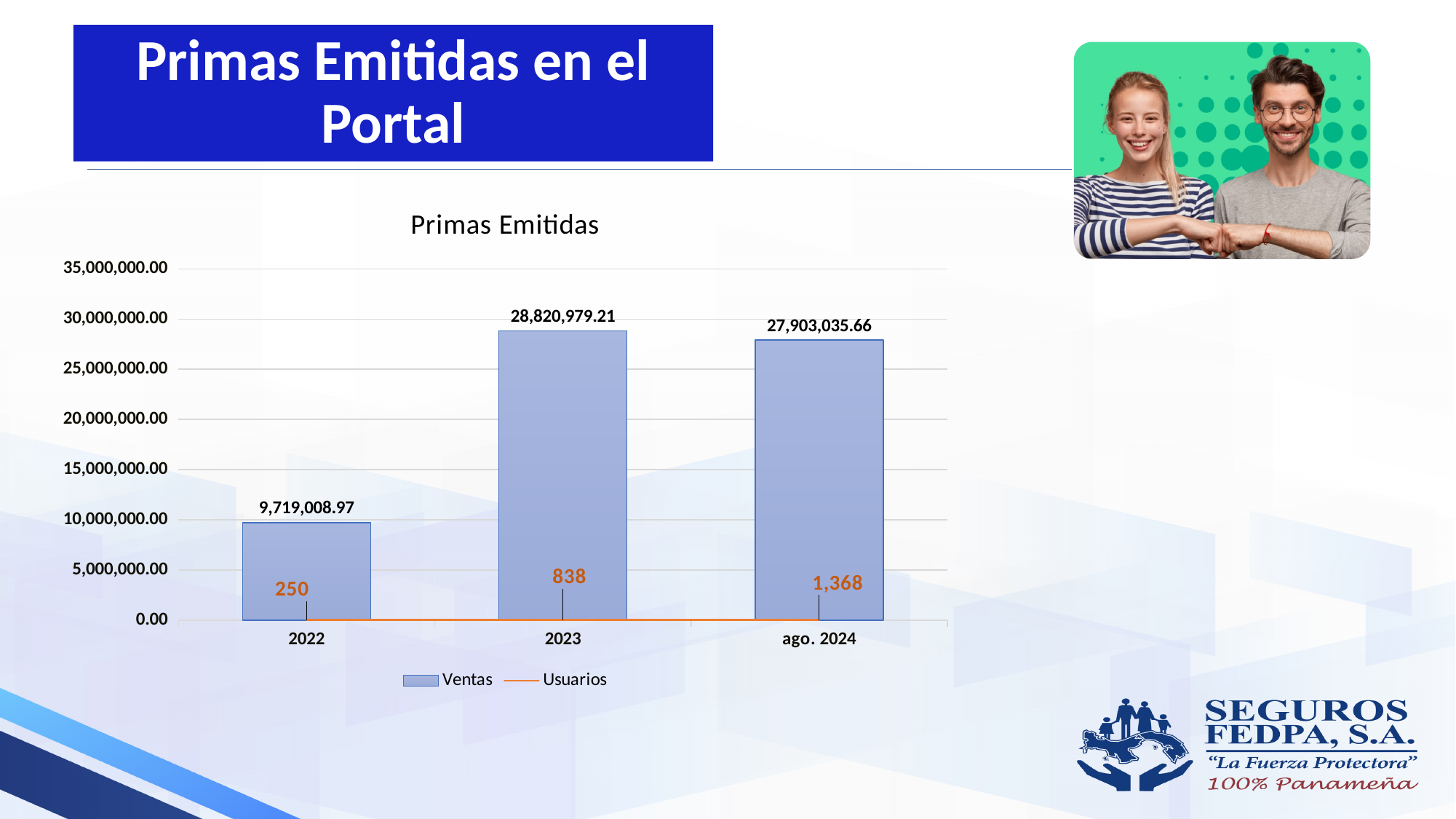
What is the difference between the Ventas values for 2023 and ago. 2024? 917,943.55 What is the Usuarios value for 2023? 838 Which is larger, the Ventas value for 2022 or for ago. 2024? ago. 2024 What is the Usuarios value for ago. 2024? 1,368 How many periods are shown on the x axis? 3 What is the Ventas value for 2023? 28,820,979.21 Which period has the lowest Usuarios value? 2022 What is the Ventas value for 2022? 9,719,008.97 What is the difference between the Usuarios values for ago. 2024 and 2023? 530 What is the title of the chart? Primas Emitidas How many series does the legend list? 2 Which period has the highest Ventas value? 2023